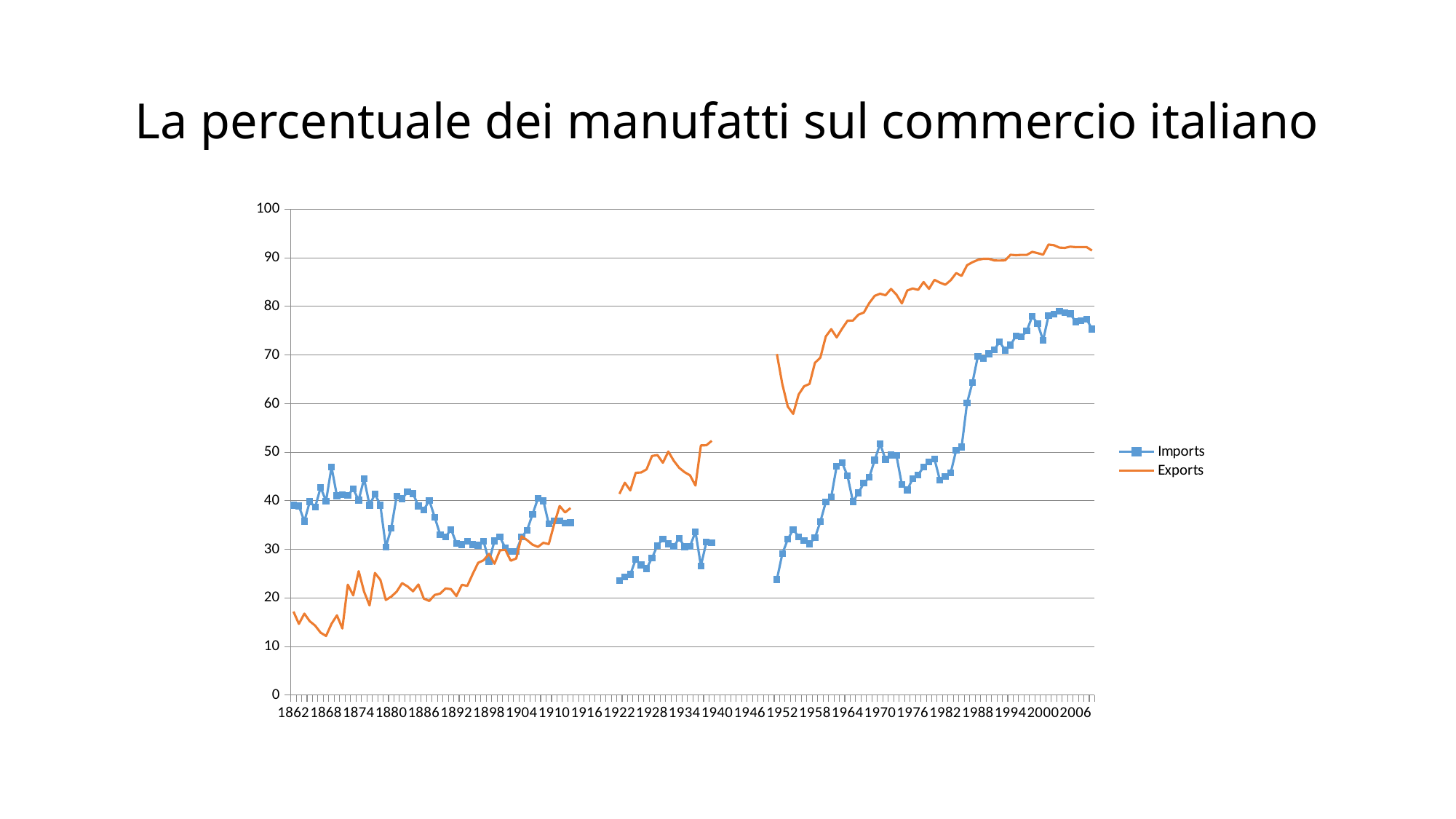
Is the value for Imports in 2006 greater or less than 70? greater In 1862, which series has the larger value, Imports or Exports? Imports In 2006, which series has the larger value, Imports or Exports? Exports How many series does the legend list? 2 Do the Exports values rise or fall from 1952 to 2006? rise Is the value for Exports in 1868 greater or less than 20? less What is the title of the chart on the slide? La percentuale dei manufatti sul commercio italiano Is the value for Exports in 1976 greater or less than 80? greater What are the two series named in the legend? Imports and Exports What kind of chart is shown on the slide? line chart